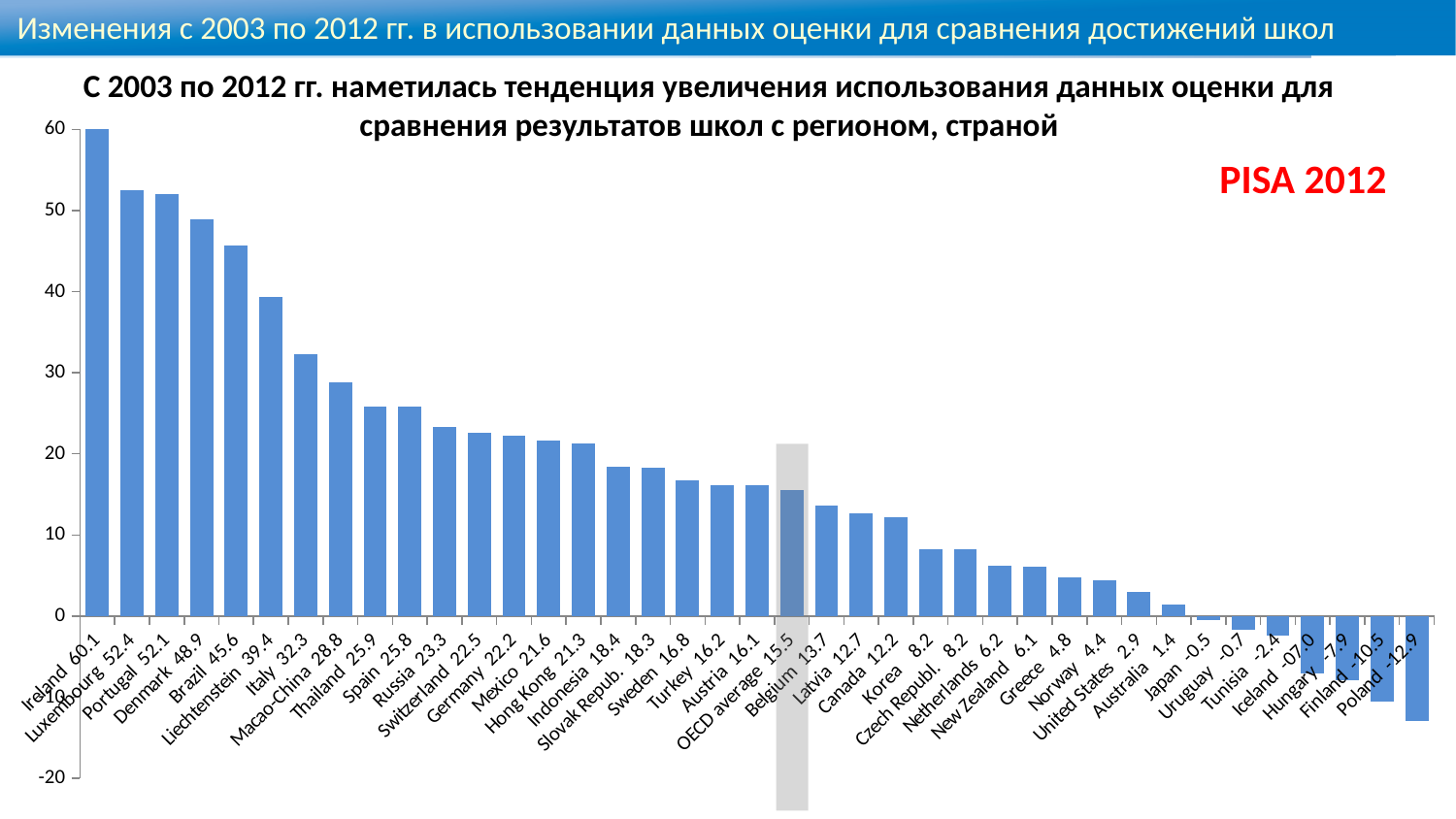
What is the value for Russia? 23.3 Which has a larger value, Germany or Mexico? Germany Is the value for Brazil greater or less than 40? greater Which country has the highest value? Ireland What kind of chart is shown on the slide? Bar chart What is the value for the OECD average? 15.5 What is the value for Ireland? 60.1 What is the difference between the values for Luxembourg and Portugal? 0.3 Do the values rise or fall from left to right along the x axis? Fall What is the value for Poland? -12.9 Which country has the lowest value? Poland Which assessment is named in red text on the slide? PISA 2012